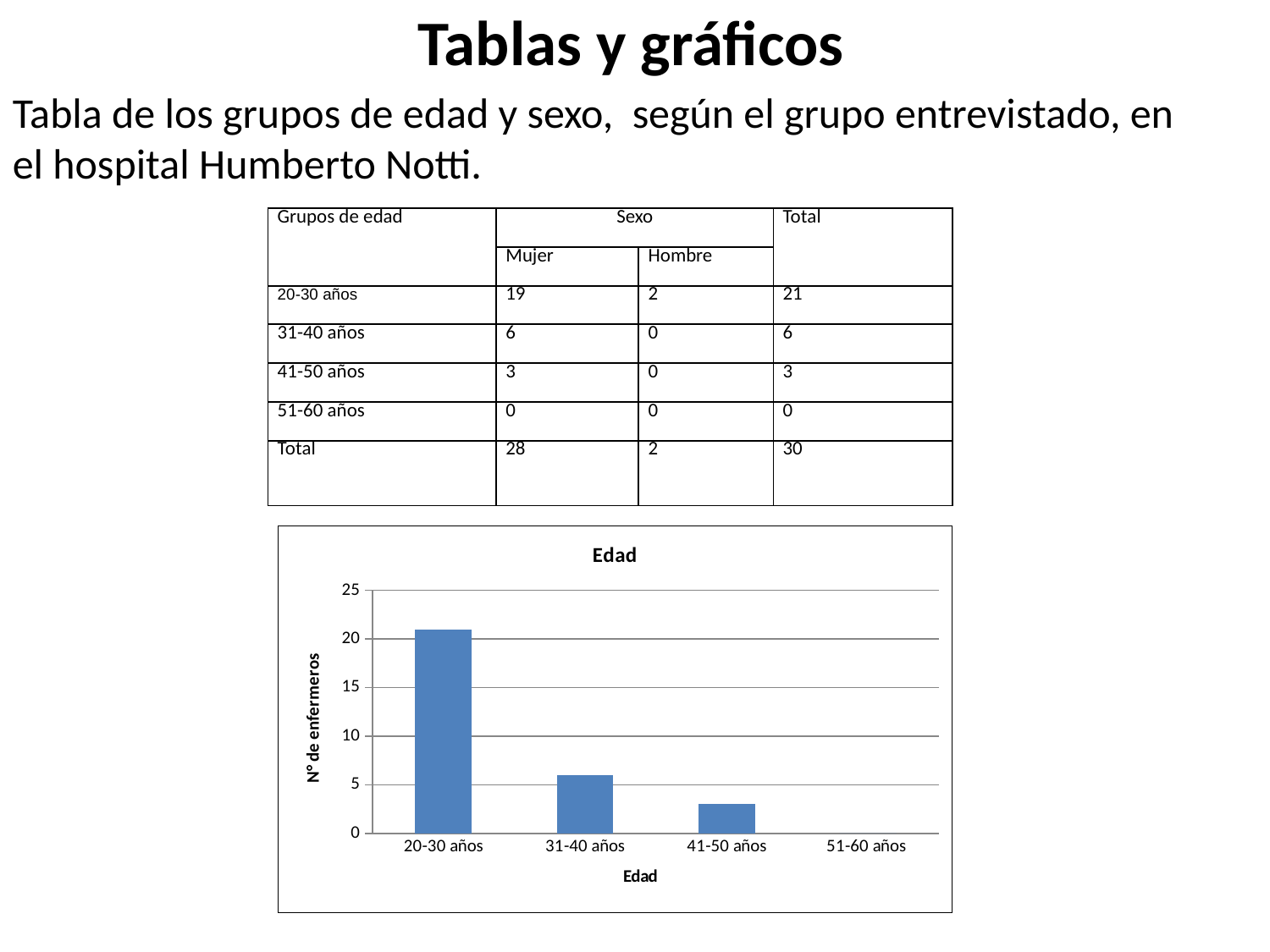
How many age categories are shown on the x axis of the chart? 4 According to the table on the slide, what is the total number of nurses in the 20-30 años group plotted in the chart? 21 What is the title of the chart? Edad What is the label of the vertical axis of the chart? N° de enfermeros Is the value for 20-30 años greater or less than 20? greater Do the values rise or fall as you move from 20-30 años to 51-60 años along the x axis? fall Is the value for 41-50 años greater or less than 5? less Is the value for 31-40 años greater or less than 10? less Which is larger in the chart, the value for 31-40 años or the value for 41-50 años? 31-40 años Which age group has the lowest value in the chart? 51-60 años What kind of chart is shown on the slide? bar chart Which age group has the highest bar in the chart? 20-30 años